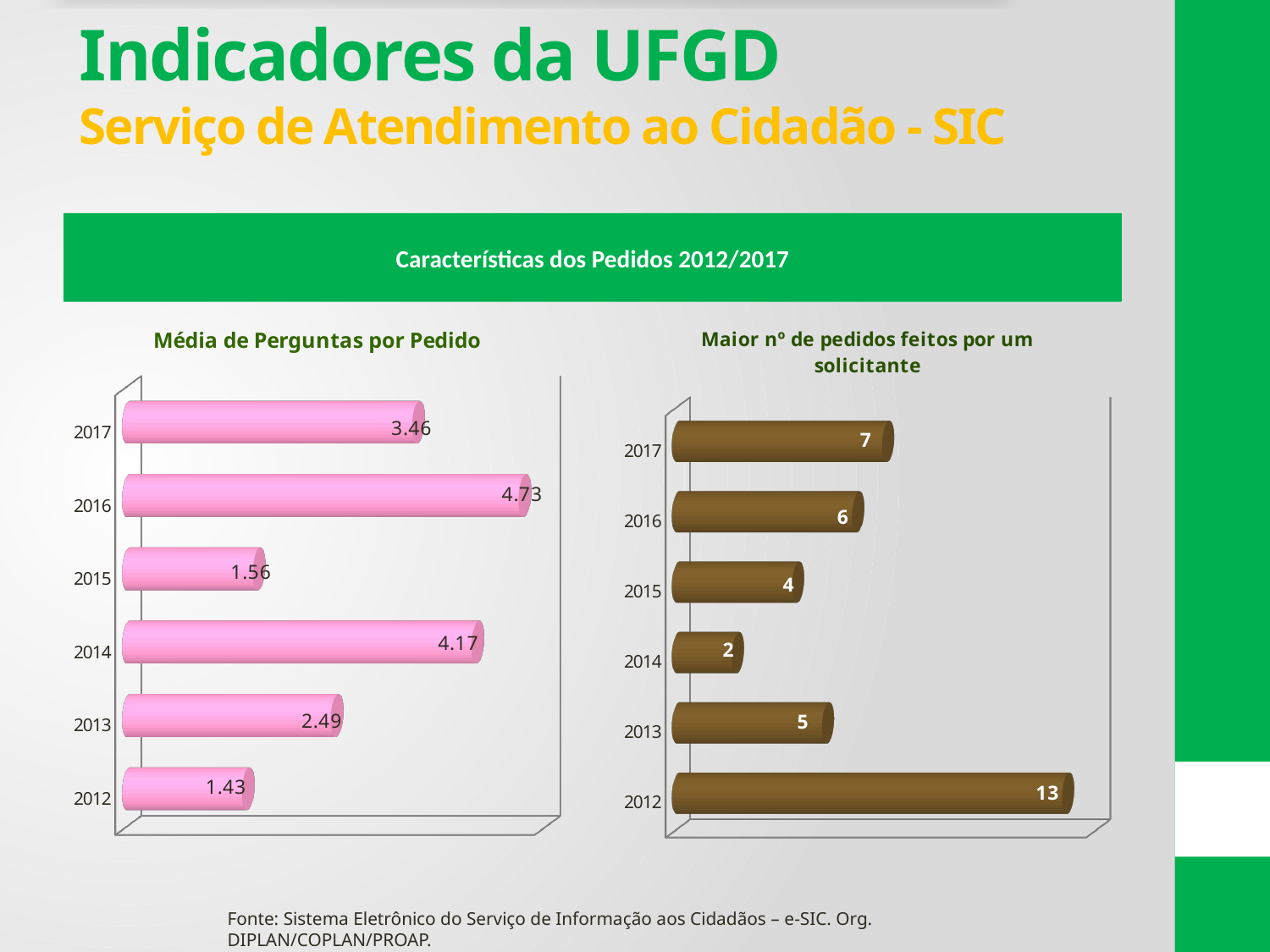
In the 'Média de Perguntas por Pedido' chart, what is the difference between the values for 2014 and 2013? 1.68 In the 'Média de Perguntas por Pedido' chart, which year has the highest value? 2016 What colour are the bars in the 'Maior nº de pedidos feitos por um solicitante' chart? Brown In the 'Média de Perguntas por Pedido' chart, what is the value for 2016? 4.73 In the 'Média de Perguntas por Pedido' chart, which year has the lowest value? 2012 In the 'Maior nº de pedidos feitos por um solicitante' chart, which is larger, the value for 2013 or the value for 2015? 2013 In the 'Maior nº de pedidos feitos por um solicitante' chart, which year has the lowest value? 2014 In the 'Média de Perguntas por Pedido' chart, which is larger, the value for 2017 or the value for 2015? 2017 In the 'Maior nº de pedidos feitos por um solicitante' chart, what is the value for 2012? 13 In the 'Maior nº de pedidos feitos por um solicitante' chart, what is the difference between the values for 2017 and 2016? 1 How many years are shown in the 'Maior nº de pedidos feitos por um solicitante' chart? 6 What kind of chart is the 'Média de Perguntas por Pedido' chart? Bar chart